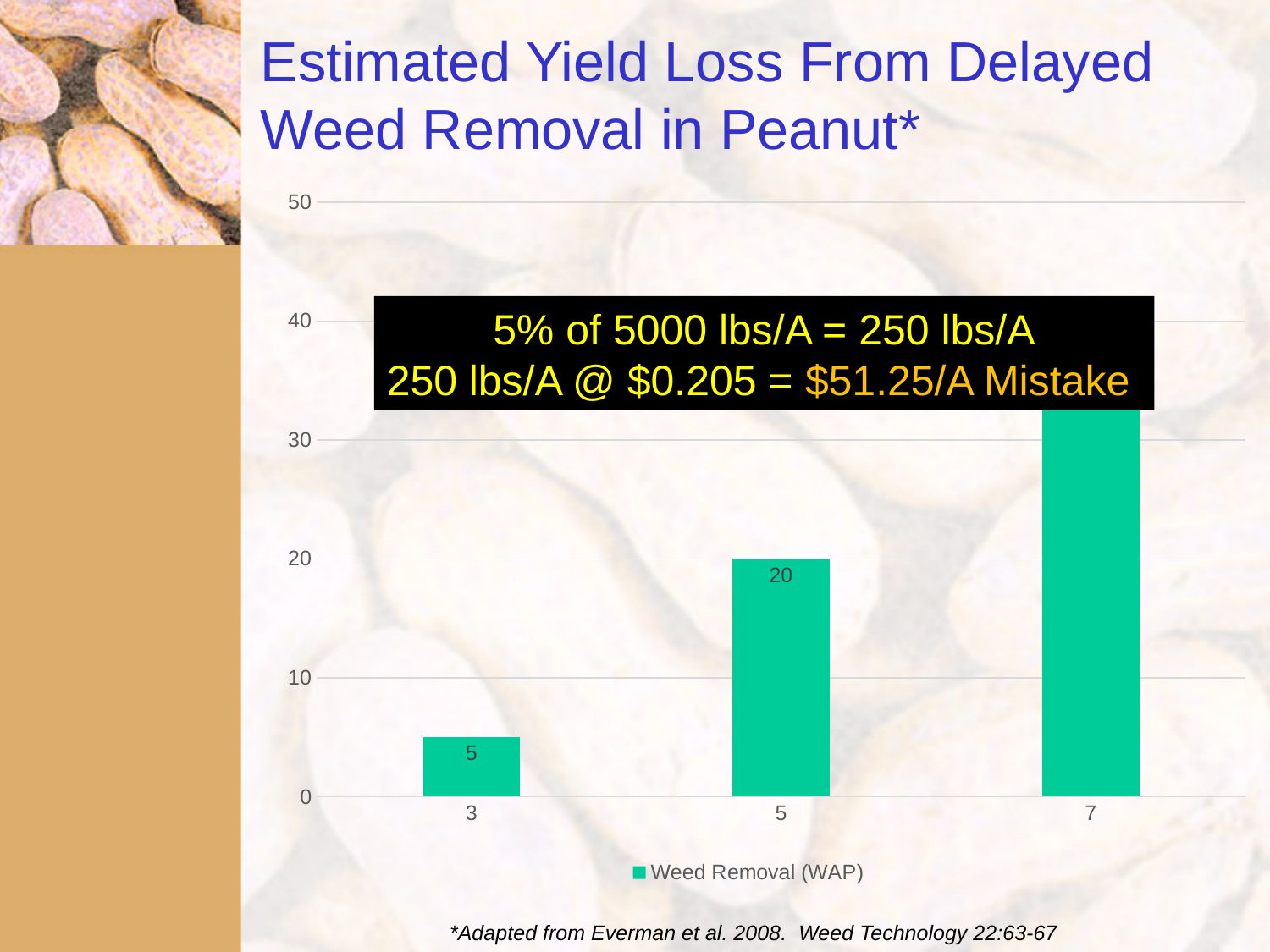
Is the value for category 7 greater or less than 30? greater What kind of chart is shown on the slide? bar chart Which category has the highest bar? 7 How many categories are shown on the x axis? 3 What is the value for category 5? 20 What is the value for category 3? 5 What is the difference between the values for category 5 and category 3? 15 Which category has the lowest bar? 3 How many series does the legend list? 1 Is the value for category 7 greater or less than 40? less Which is larger, the value for category 5 or the value for category 3? 5 Do the values rise or fall as you move from category 3 to category 7? rise